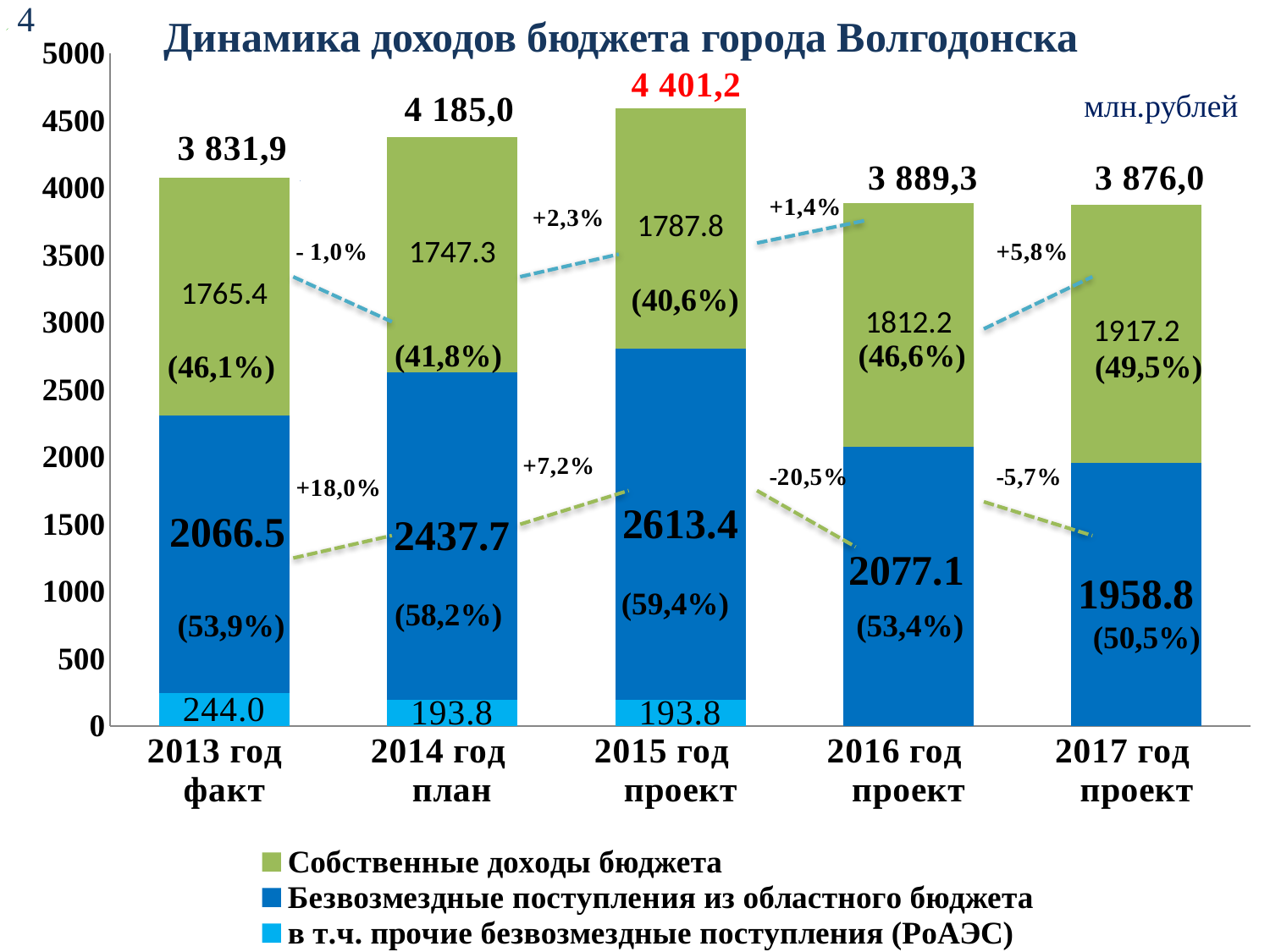
What is the total budget income shown above the bar for 2016 год проект? 3 889,3 How many series does the legend list? 3 What kind of chart is shown on the slide? bar chart What percentage share is printed for 'Собственные доходы бюджета' in 2013 год факт? (46,1%) Which year has the lowest value of 'Безвозмездные поступления из областного бюджета'? 2017 год проект Which year has the highest total budget income? 2015 год проект What is the value of 'в т.ч. прочие безвозмездные поступления (РоАЭС)' for 2013 год факт? 244.0 Which is larger: 'Безвозмездные поступления из областного бюджета' in 2015 год проект or in 2016 год проект? 2015 год проект What is the value of 'Собственные доходы бюджета' for 2015 год проект? 1787.8 How many year categories are shown on the x axis? 5 What is the difference between 'Собственные доходы бюджета' in 2017 год проект and in 2016 год проект? 105.0 What is the value of 'Безвозмездные поступления из областного бюджета' for 2014 год план? 2437.7